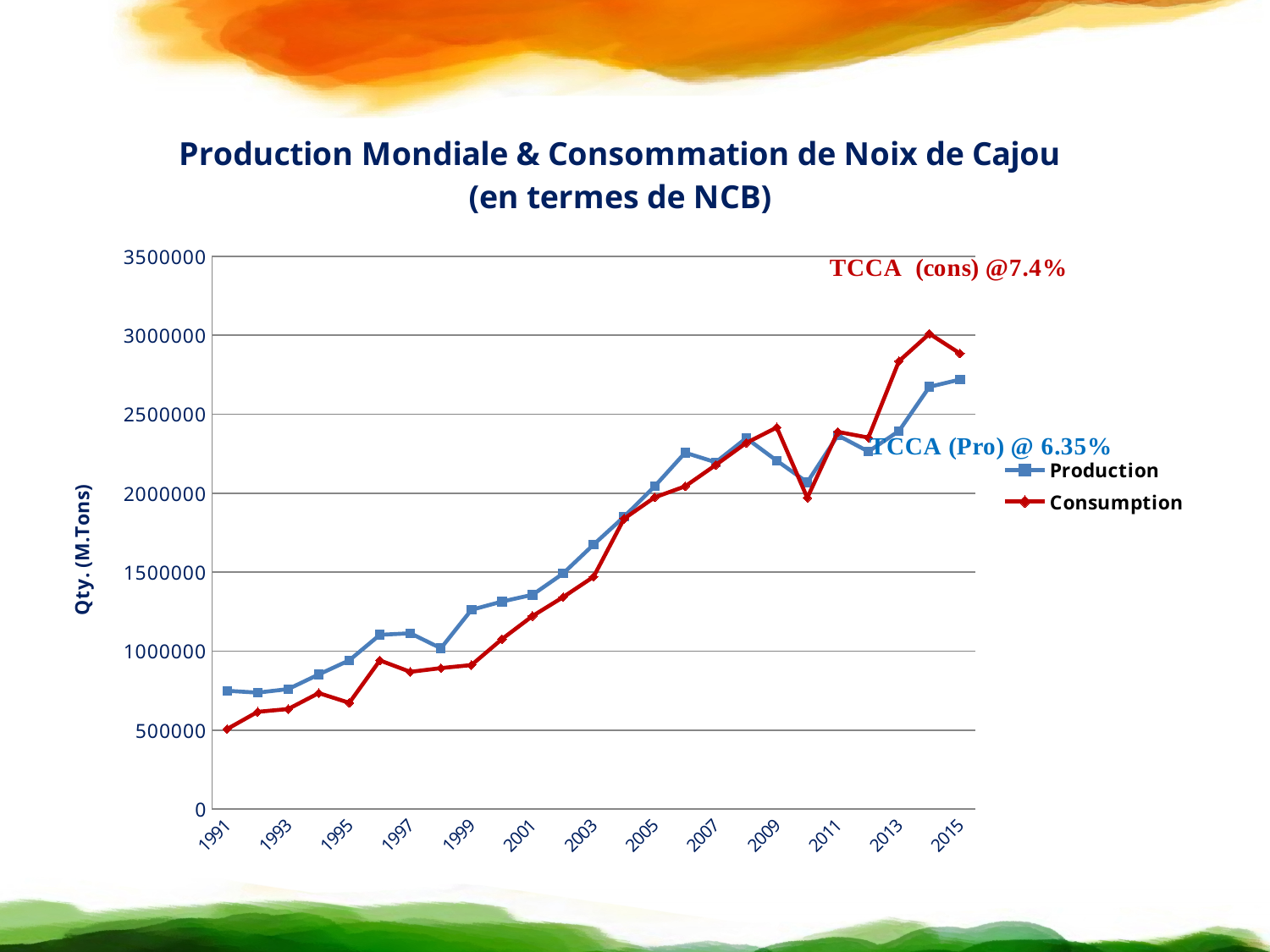
How many series does the legend list? 2 Is the Consumption value for 2013 greater or less than 2500000? greater In which year is Consumption at its lowest? 1991 In 1991, which is larger, Production or Consumption? Production Do the Production values generally rise or fall from 1991 to 2015? Rise In which year does Consumption reach its highest value? 2014 What is the label on the vertical axis? Qty. (M.Tons) Is the Production value for 1991 greater or less than 1000000? less What are the two series named in the legend? Production and Consumption In 2015, which is larger, Production or Consumption? Consumption Is the Production value for 2003 greater or less than 1500000? greater What kind of chart is shown on the slide? Line chart